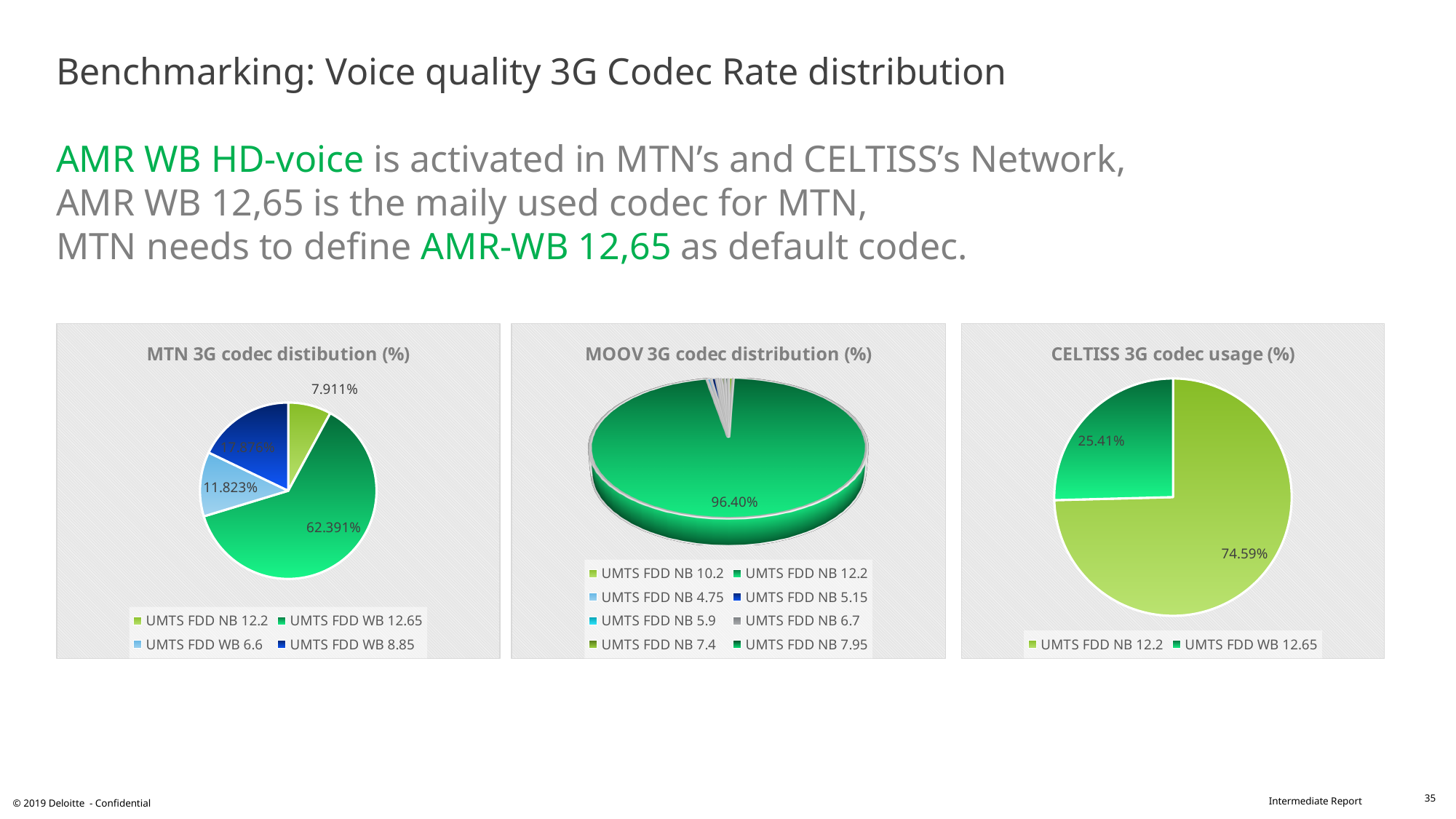
In the MTN 3G codec distribution chart, what percentage is shown for UMTS FDD WB 12.65? 62.391% In the MTN 3G codec distribution chart, what is the difference between the UMTS FDD WB 8.85 and UMTS FDD WB 6.6 shares? 6.053% How many codecs are listed in the legend of the MOOV 3G codec distribution chart? 8 In the CELTISS 3G codec usage chart, which is larger: UMTS FDD NB 12.2 or UMTS FDD WB 12.65? UMTS FDD NB 12.2 In the MTN 3G codec distribution chart, what percentage is shown for UMTS FDD NB 12.2? 7.911% In the MTN 3G codec distribution chart, which codec has the smallest slice? UMTS FDD NB 12.2 In the MTN 3G codec distribution chart, which codec has the largest slice? UMTS FDD WB 12.65 In the MOOV 3G codec distribution chart, what percentage is shown for the dominant slice? 96.40% In the CELTISS 3G codec usage chart, what percentage is shown for UMTS FDD NB 12.2? 74.59% In the CELTISS 3G codec usage chart, what is the difference between the UMTS FDD NB 12.2 and UMTS FDD WB 12.65 shares? 49.18% What type of chart is the CELTISS 3G codec usage chart? Pie chart How many codecs are listed in the legend of the MTN 3G codec distribution chart? 4